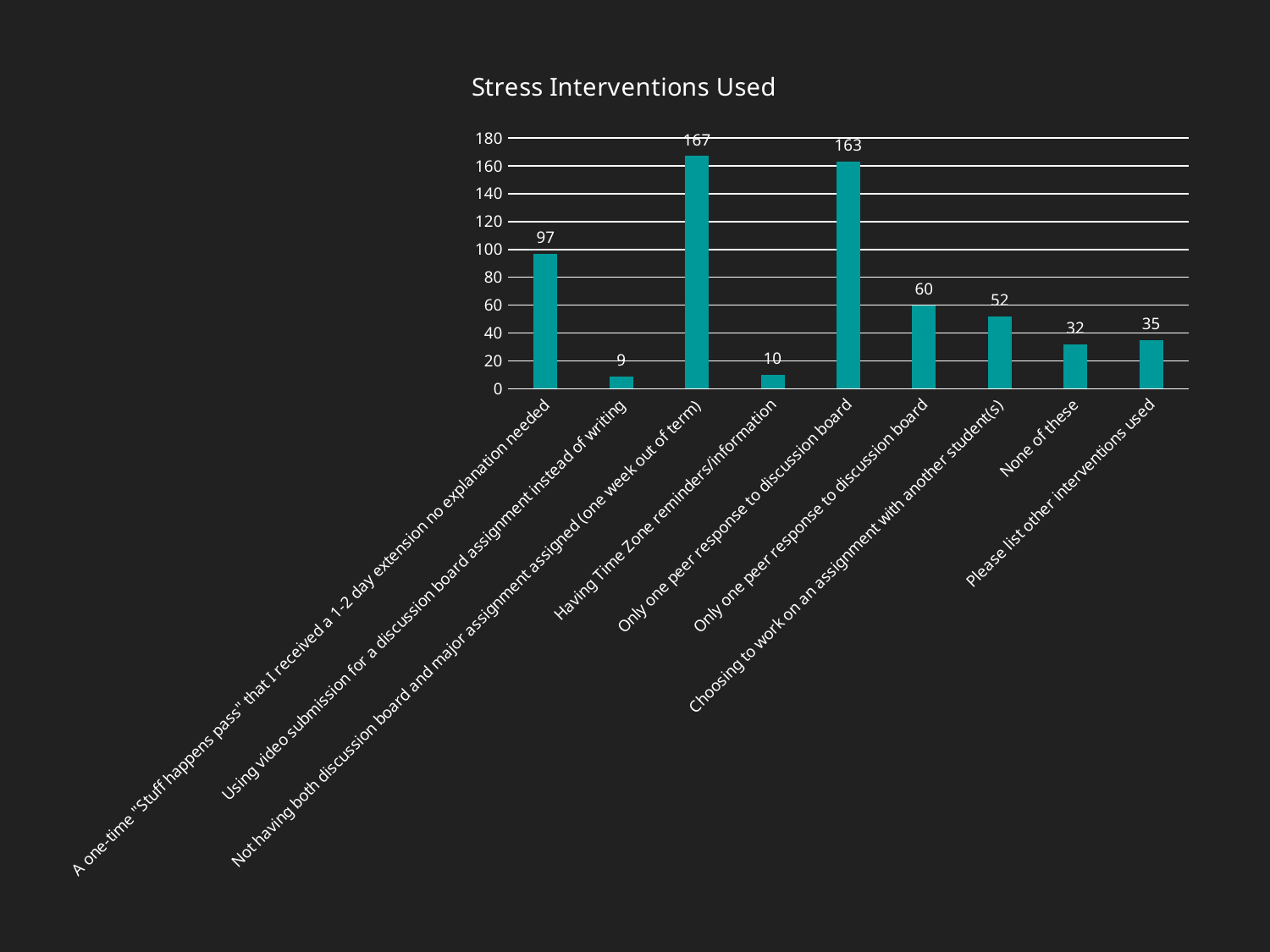
What is the value for "Please list other interventions used"? 35 Is the value for "Choosing to work on an assignment with another student(s)" greater or less than 60? less What type of chart is shown on the slide? bar chart What is the value for "Having Time Zone reminders/information"? 10 What is the value for "None of these"? 32 What is the difference between the value for "Choosing to work on an assignment with another student(s)" and the value for "None of these"? 20 What is the value for "A one-time "Stuff happens pass" that I received a 1-2 day extension no explanation needed"? 97 Which category has the highest value? Not having both discussion board and major assignment assigned (one week out of term) What is the title of the chart? Stress Interventions Used Which is larger: the value for "Please list other interventions used" or the value for "None of these"? Please list other interventions used How many categories are plotted in the chart? 9 Which category has the lowest value? Using video submission for a discussion board assignment instead of writing